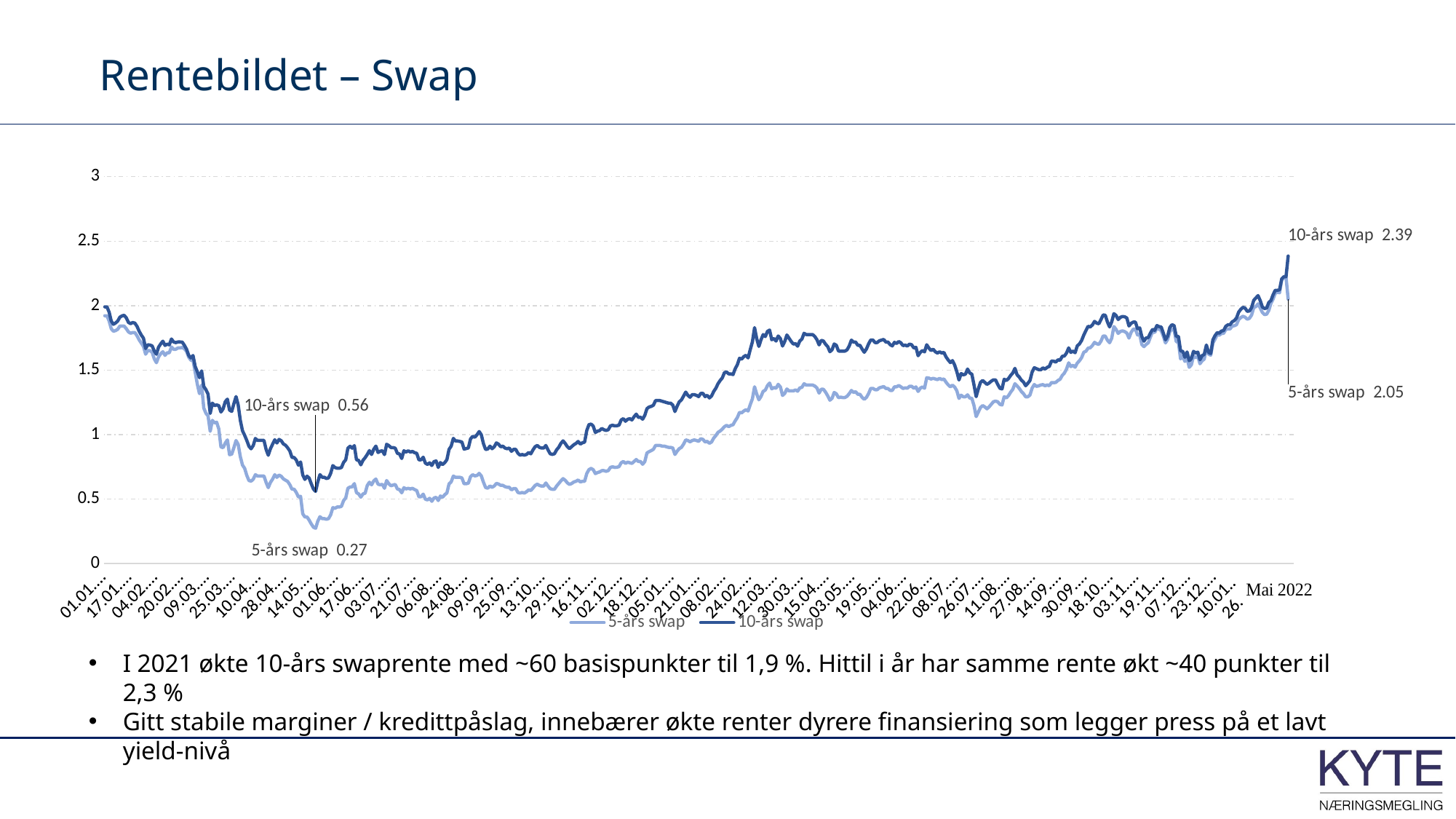
Does the 10-års swap series rise or fall between its labelled low of 0.56 and its labelled end value of 2.39? Rise What is the labelled end value of the 10-års swap series at the right edge of the chart? 2.39 What is the labelled end value of the 5-års swap series at the right edge of the chart? 2.05 Is the value of the 10-års swap series at the start of the chart (01.01) greater or less than 1.5? greater What is the difference between the labelled low values of the 10-års swap (0.56) and the 5-års swap (0.27)? 0.29 At the right edge of the chart, which series has the higher labelled value, 5-års swap or 10-års swap? 10-års swap What is the difference between the labelled end values of the 10-års swap (2.39) and the 5-års swap (2.05)? 0.34 What is the labelled low value of the 10-års swap series? 0.56 What kind of chart is shown on the slide? Line chart What are the two series named in the legend? 5-års swap and 10-års swap What is the labelled low value of the 5-års swap series? 0.27 How many series does the legend list? 2